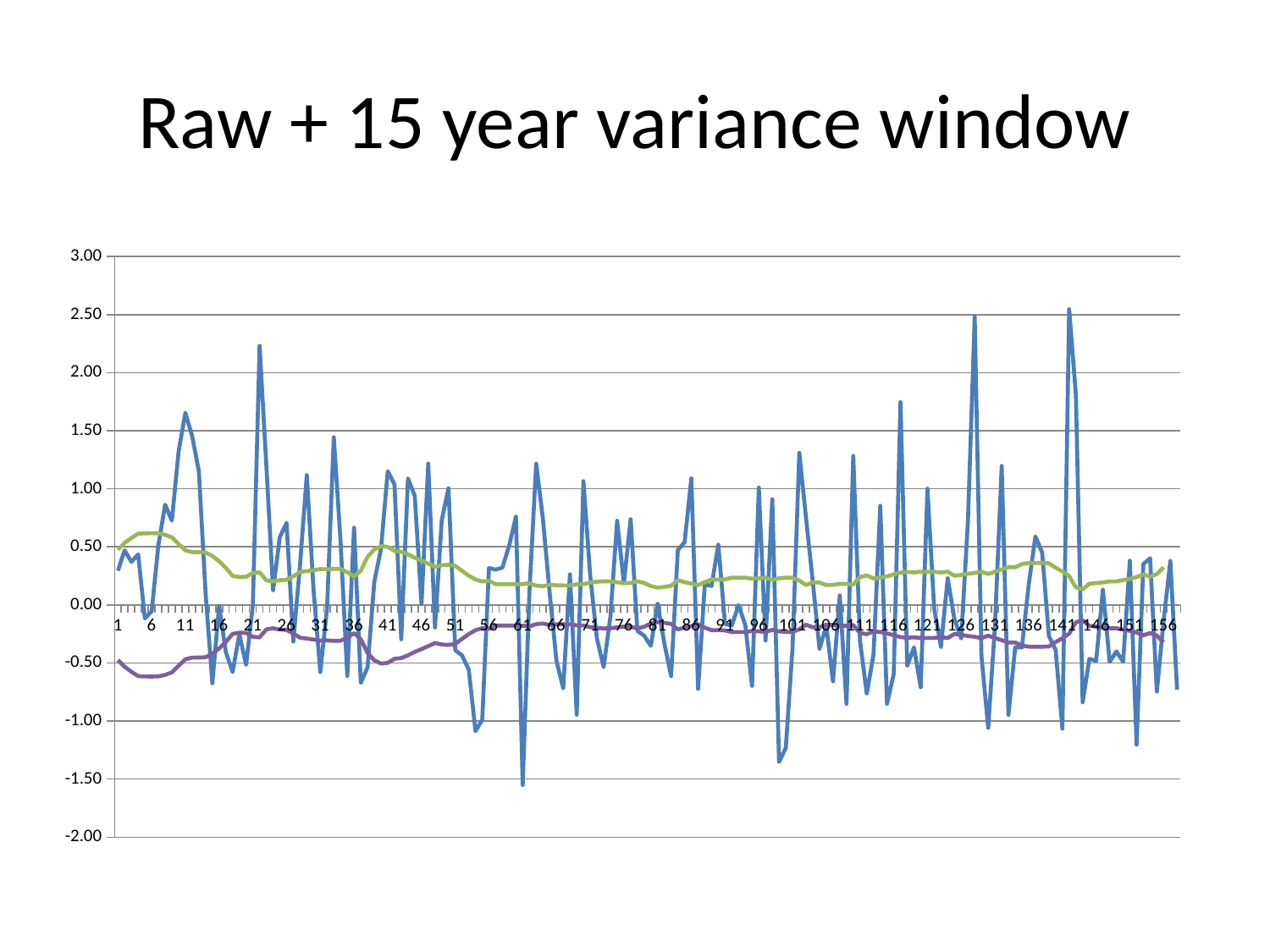
Does the green line overall rise or fall from x = 1 to x = 156? fall Is the highest peak of the blue line, near x = 141, greater or less than 2.00? greater Is the lowest point of the blue line, near x = 61, greater or less than -1.00? less How many lines are plotted on the chart? 3 Does the purple line overall rise or fall from x = 1 to x = 156? rise What is the highest value labelled on the vertical axis? 3.00 What kind of chart is shown on the slide? line chart What is the lowest value labelled on the vertical axis? -2.00 Is the value of the purple line at x = 6 greater or less than -0.50? less What is the title of the chart on the slide? Raw + 15 year variance window What is the last label shown on the horizontal axis? 156